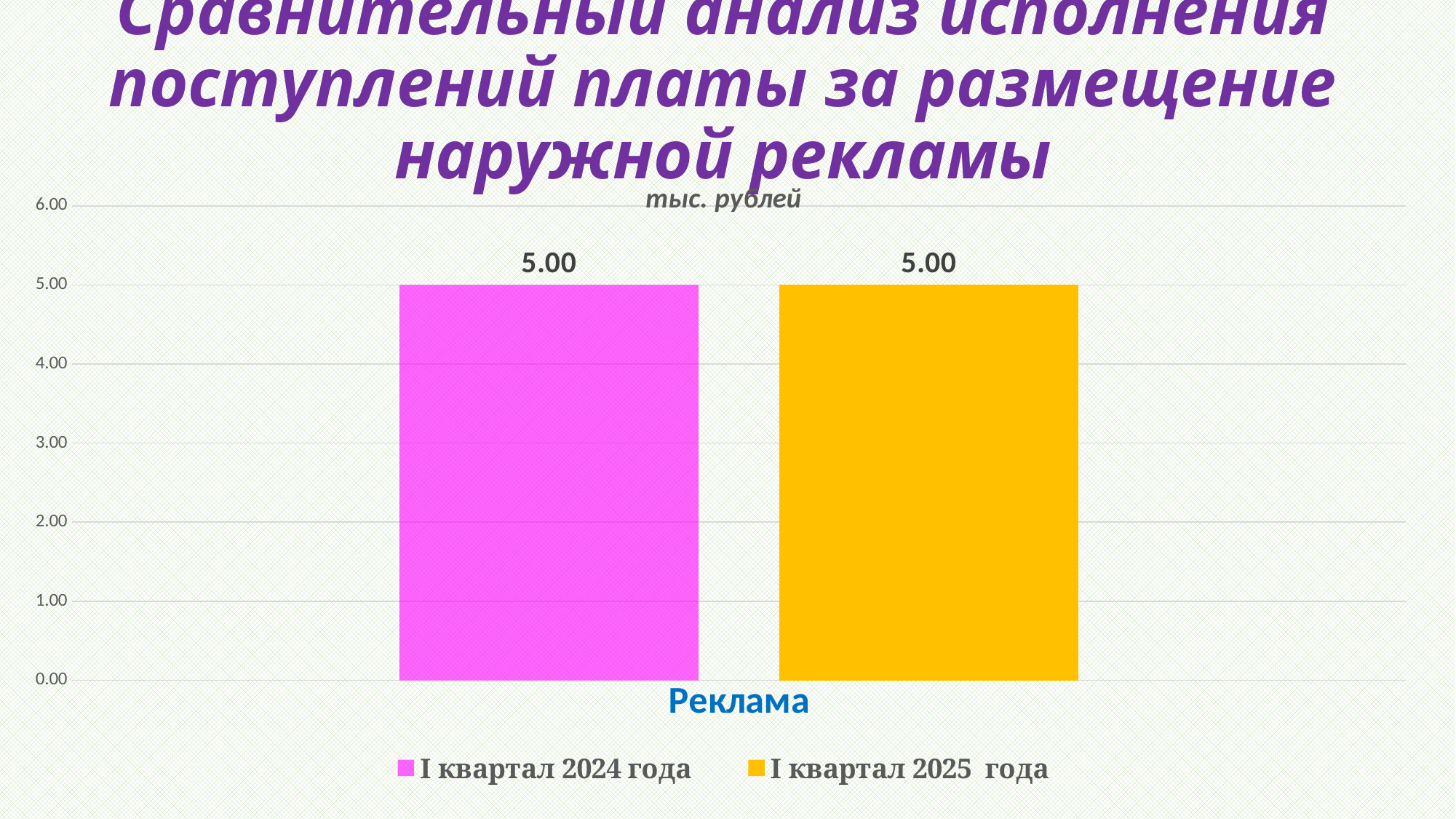
What is the value for I квартал 2025 года in the Реклама category? 5.00 What is the name of the category on the x axis? Реклама What is the total of the two series values for Реклама? 10.00 What is the difference between the I квартал 2025 года and I квартал 2024 года values for Реклама? 0.00 What kind of chart is shown on the slide? bar chart How many series does the legend list? 2 Is the value for I квартал 2024 года greater or less than 4.00? greater Is the value for I квартал 2025 года greater or less than 6.00? less What unit is shown above the chart? тыс. рублей How many categories are shown on the x axis? 1 What is the value for I квартал 2024 года in the Реклама category? 5.00